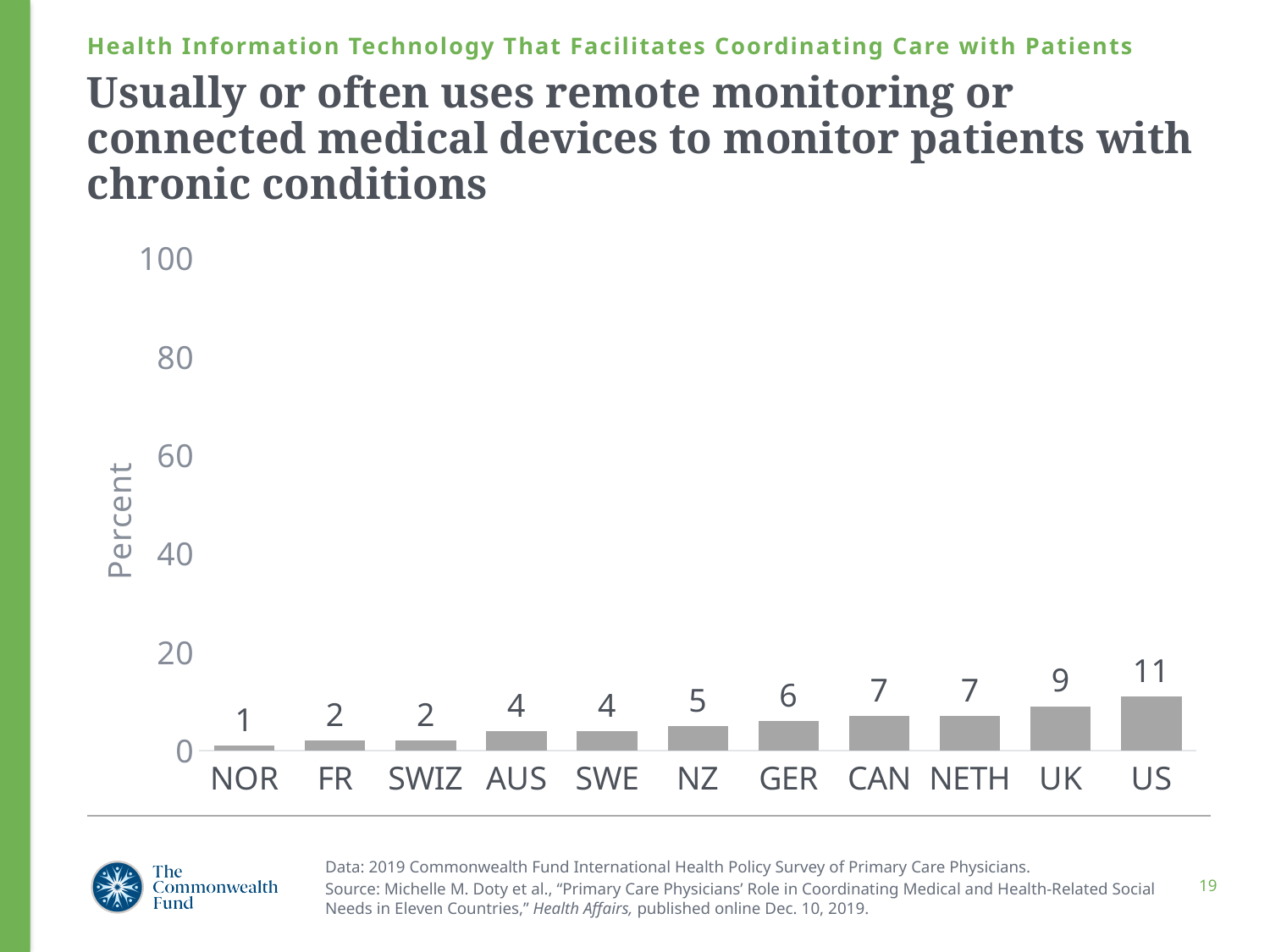
Is the value for the US greater or less than 20? less Which country has the lowest value? NOR Which country has the highest value? US Do the values rise or fall from left to right along the x axis? rise Which has a larger value, NZ or SWE? NZ How many countries are shown on the chart? 11 What is the value for the US? 11 What kind of chart is shown on the slide? bar chart What is the value for GER? 6 What is the label on the vertical axis? Percent What is the difference between the values for the US and the UK? 2 What is the value for NOR? 1